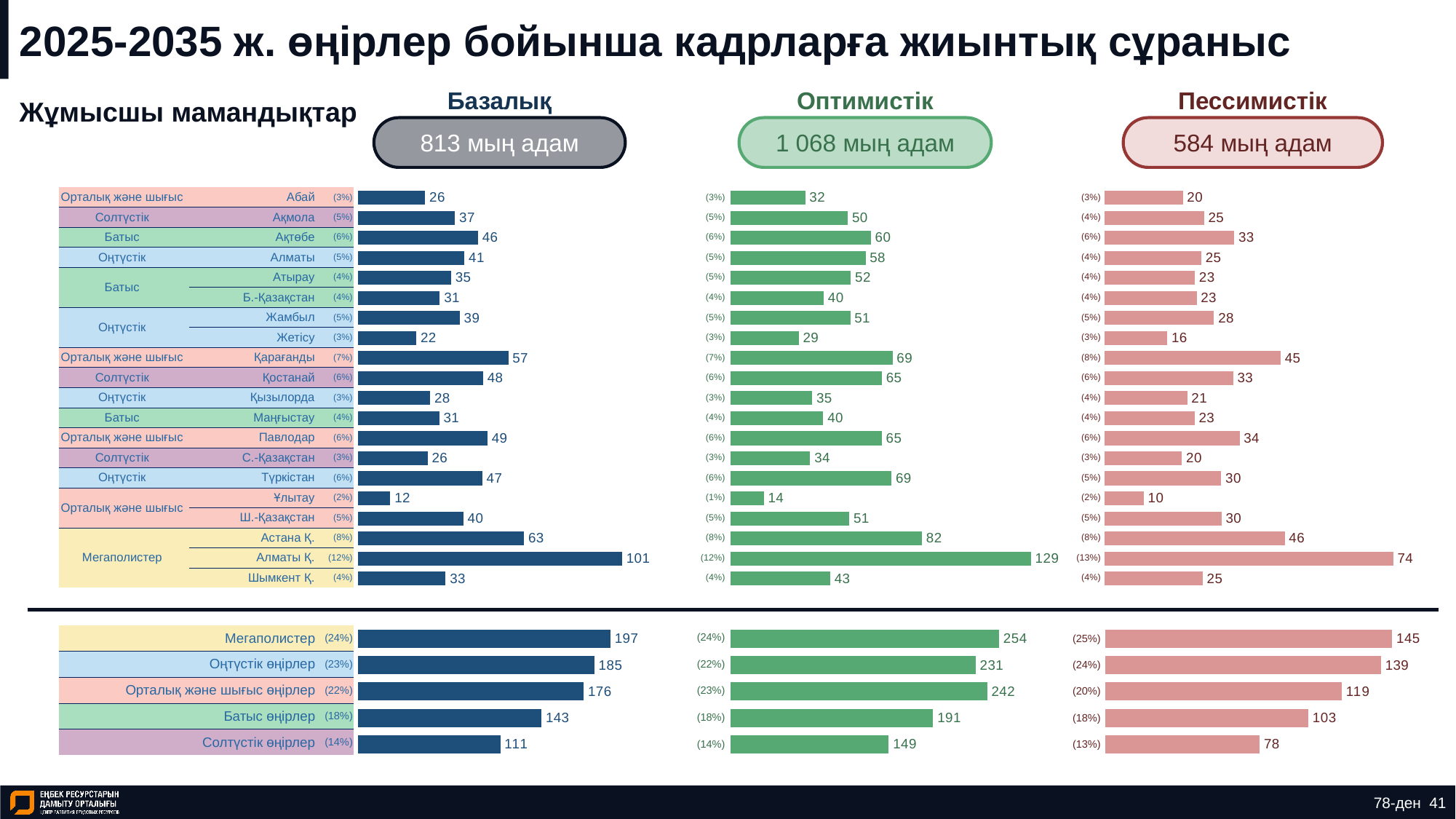
In the Пессимистік chart, what is the difference between the values for Алматы қ. and Шымкент қ.? 49 In the Базалық chart, what percentage share is shown for Алматы қ.? 12% In the Базалық chart, which region in the upper section has the highest value? Алматы қ. What total is shown in the box under the Пессимистік heading? 584 мың адам In the Оптимистік chart, which region in the upper section has the lowest value? Ұлытау In the lower section of the Оптимистік chart, what is the value for Оңтүстік өңірлер? 231 What kind of chart is used for the Оптимистік scenario? Bar chart How many regions are listed in the upper section of the Базалық chart? 20 In the Пессимистік chart, what is the value for Астана қ.? 46 In the Базалық chart, which is larger: the value for Қостанай or the value for Жетісу? Қостанай In the Оптимистік chart, what is the value for Алматы қ.? 129 In the Базалық chart, what is the value for Қарағанды? 57